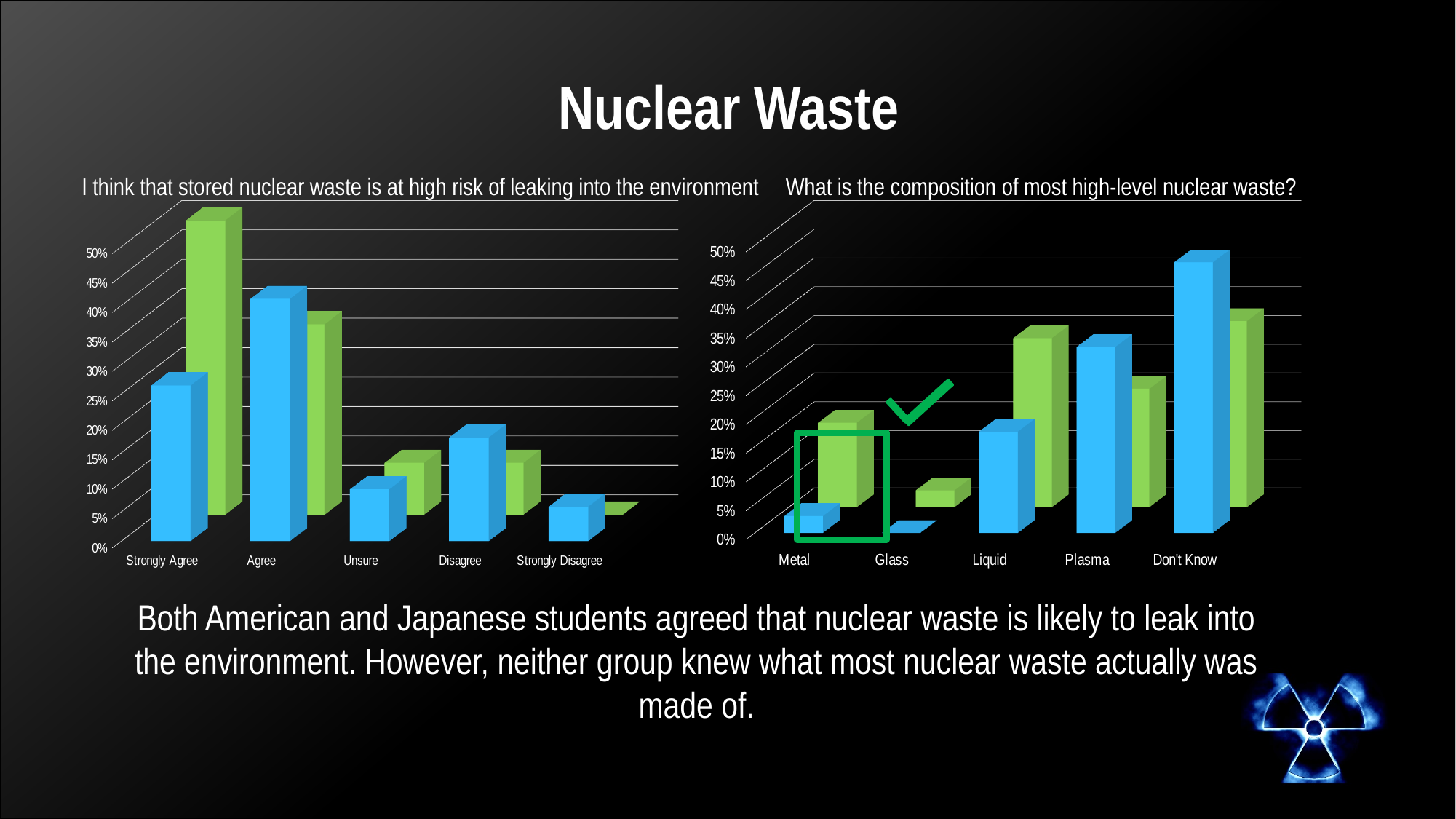
In the chart "I think that stored nuclear waste is at high risk of leaking into the environment", which category has the tallest blue bar? Agree In the chart "I think that stored nuclear waste is at high risk of leaking into the environment", is the blue bar for Unsure greater or less than 15%? less In the chart "I think that stored nuclear waste is at high risk of leaking into the environment", how many response categories are shown on the x axis? 5 In the chart "What is the composition of most high-level nuclear waste?", which category has the lowest blue bar? Glass In the chart "What is the composition of most high-level nuclear waste?", is the blue bar for Don't Know greater or less than 40%? greater In the chart "What is the composition of most high-level nuclear waste?", which category is marked with a green check mark and box? Glass In the chart "I think that stored nuclear waste is at high risk of leaking into the environment", which category has the tallest green bar? Strongly Agree What kind of chart is used for "I think that stored nuclear waste is at high risk of leaking into the environment"? Bar chart In the chart "What is the composition of most high-level nuclear waste?", which is larger for the blue bars: Plasma or Liquid? Plasma In the chart "What is the composition of most high-level nuclear waste?", how many answer categories are shown on the x axis? 5 In the chart "What is the composition of most high-level nuclear waste?", which category has the tallest blue bar? Don't Know